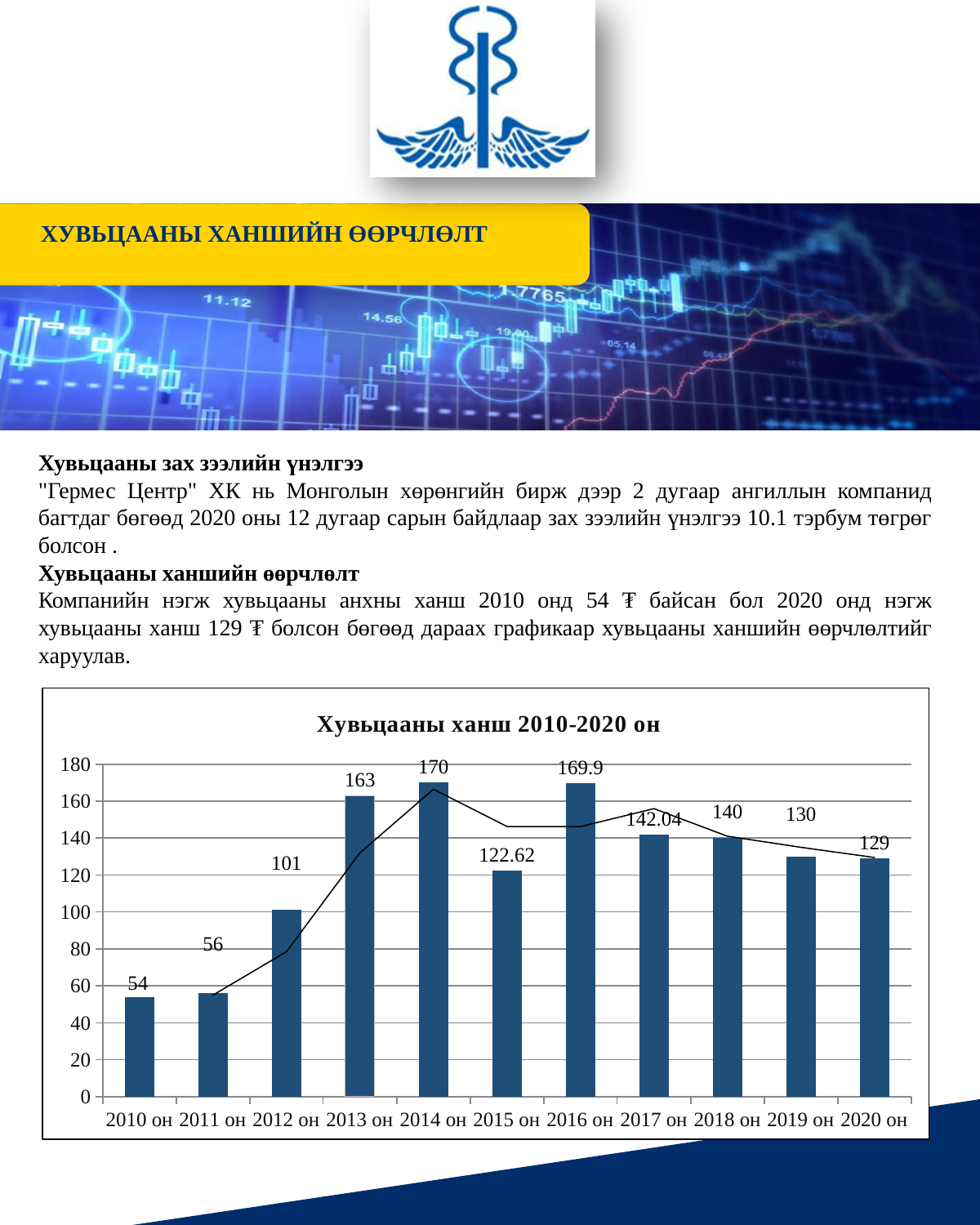
Do the values rise or fall from 2016 он to 2020 он? fall What is the value for 2016 он in the chart? 169.9 Which is larger, the value for 2012 он or the value for 2013 он? 2013 он What is the value for 2020 он in the chart? 129 What kind of chart is 'Хувьцааны ханш 2010-2020 он'? bar chart Is the value for 2018 он greater or less than 160? less How many years are shown on the x axis of the chart? 11 What is the difference between the values for 2014 он and 2013 он? 7 What is the value for 2010 он in the chart 'Хувьцааны ханш 2010-2020 он'? 54 What is the value for 2015 он in the chart? 122.62 What is the value for 2017 он in the chart? 142.04 What is the difference between the values for 2020 он and 2010 он? 75